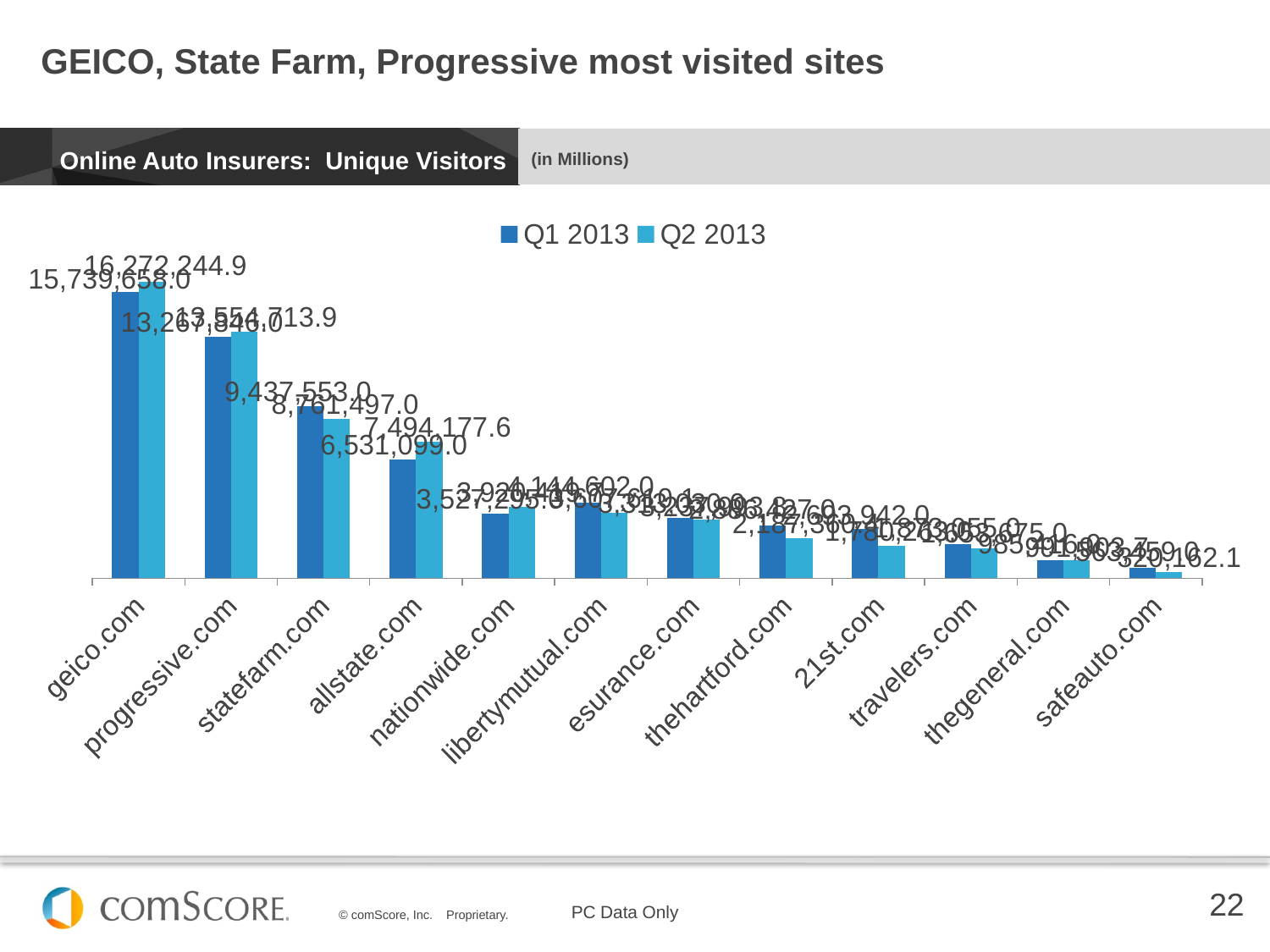
For allstate.com, which quarter has the larger value, Q1 2013 or Q2 2013? Q2 2013 How many series does the legend list? 2 How many websites are shown on the x axis? 12 What is the Q1 2013 value for allstate.com? 6,531,099.0 What is the Q2 2013 value for allstate.com? 7,494,177.6 Which website has the highest number of unique visitors? geico.com For statefarm.com, which quarter has the larger value, Q1 2013 or Q2 2013? Q1 2013 What kind of chart is shown on the slide? bar chart What is the Q1 2013 value for statefarm.com? 9,437,553.0 What is the Q2 2013 value for geico.com? 16,272,244.9 Do the values generally rise or fall moving from left to right along the x axis? fall Which website has the lowest number of unique visitors? safeauto.com